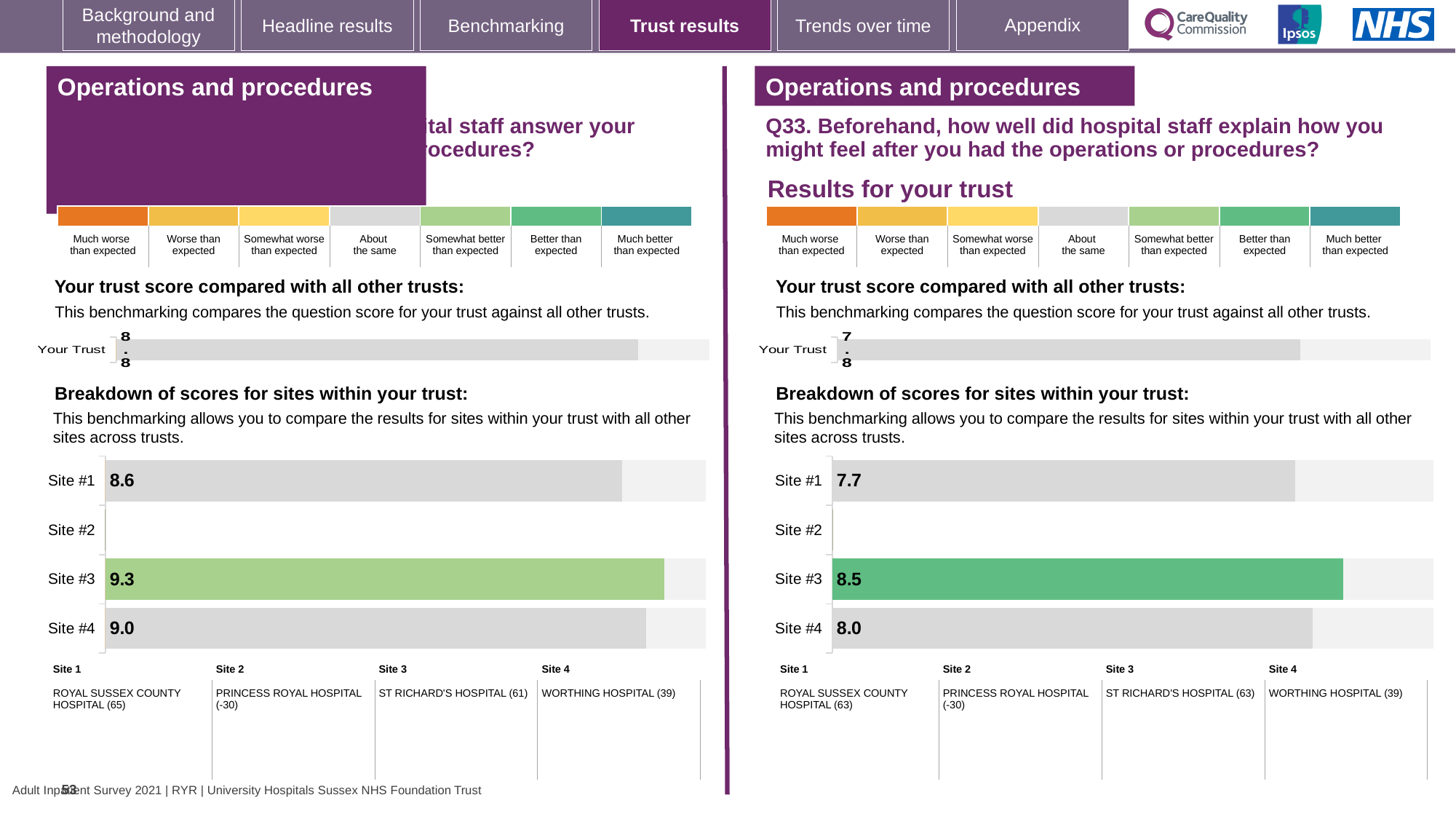
On the right-hand (Q33) site breakdown chart, what is the score for Site #3? 8.5 On the left-hand site breakdown chart, what is the difference between the scores for Site #3 and Site #4? 0.3 What is the 'Your Trust' score shown on the left-hand trust comparison chart? 8.8 How many sites are listed on the right-hand (Q33) site breakdown chart? 4 On the left-hand site breakdown chart, which site has the highest score? Site #3 On the left-hand site breakdown chart, which is larger: the score for Site #4 or the score for Site #1? Site #4 What kind of chart is the site breakdown chart on the left-hand side of the slide? Bar chart On the right-hand (Q33) site breakdown chart, which site has the lowest score among those with a bar shown? Site #1 On the right-hand (Q33) site breakdown chart, which is larger: the score for Site #4 or the score for Site #3? Site #3 On the left-hand site breakdown chart, what is the score for Site #1? 8.6 What is the 'Your Trust' score shown on the right-hand (Q33) trust comparison chart? 7.8 On the right-hand (Q33) site breakdown chart, what is the difference between the scores for Site #3 and Site #1? 0.8